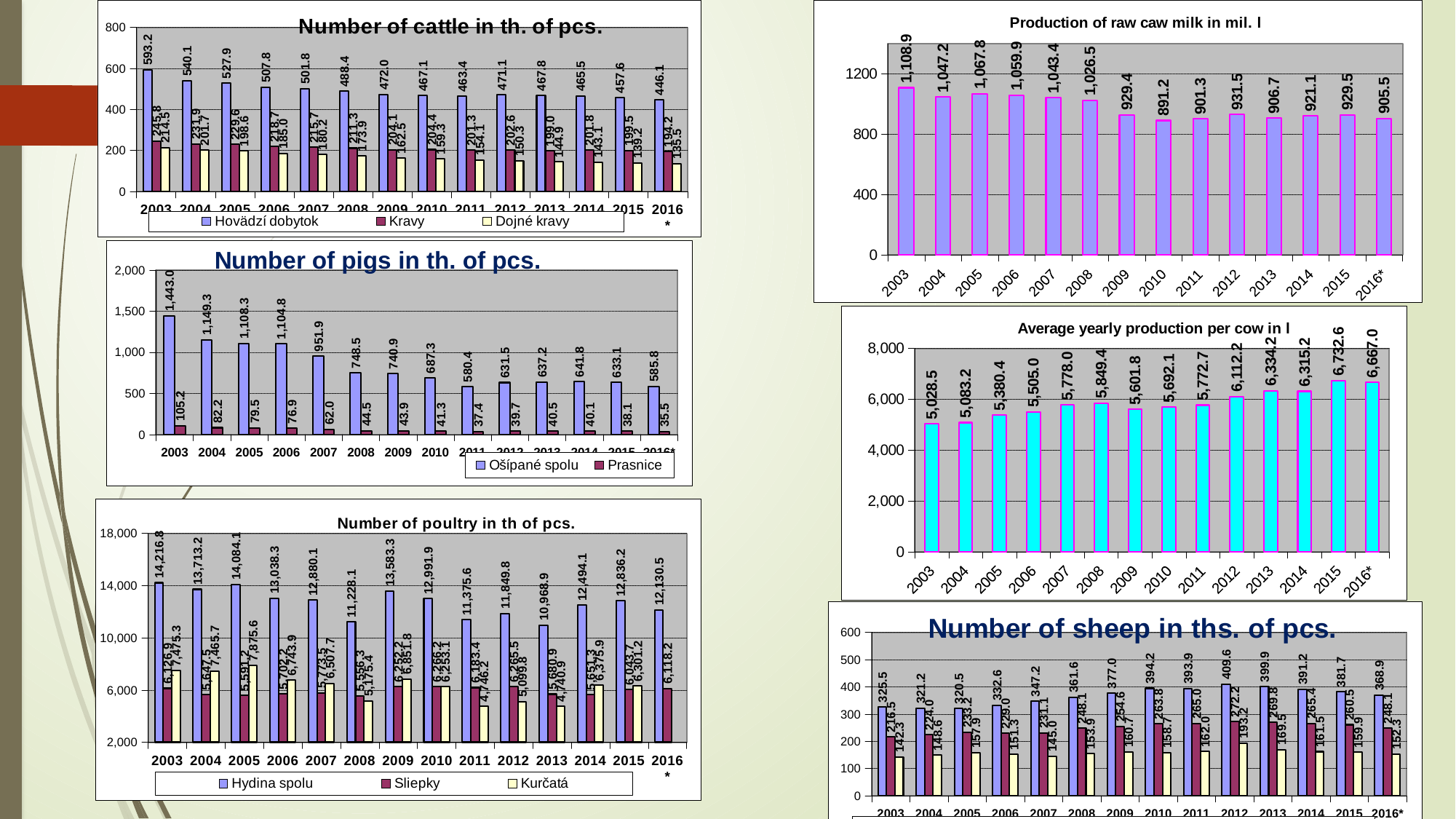
In the 'Number of poultry in th of pcs.' chart, which year has the lowest value for Hydina spolu? 2013 In the 'Production of raw caw milk in mil. l' chart, how many years are plotted? 14 In the 'Number of pigs in th. of pcs.' chart, what is the value of Ošípané spolu in 2003? 1,443.0 In the 'Number of pigs in th. of pcs.' chart, what is the difference between Ošípané spolu in 2003 and in 2016*? 857.2 In the 'Number of cattle in th. of pcs.' chart, how many series does the legend list? 3 In the 'Average yearly production per cow in l' chart, is the value for 2003 greater or less than 6,000? less In the 'Number of poultry in th of pcs.' chart, what is the value of Hydina spolu in 2016? 12,130.5 In the 'Production of raw caw milk in mil. l' chart, which year has the lowest value? 2010 In the 'Number of sheep in ths. of pcs.' chart, what kind of chart is shown? bar chart In the 'Number of pigs in th. of pcs.' chart, which year has the highest value for Prasnice? 2003 In the 'Number of cattle in th. of pcs.' chart, what is the value of Hovädzí dobytok in 2003? 593.2 In the 'Average yearly production per cow in l' chart, which year has the highest value? 2015